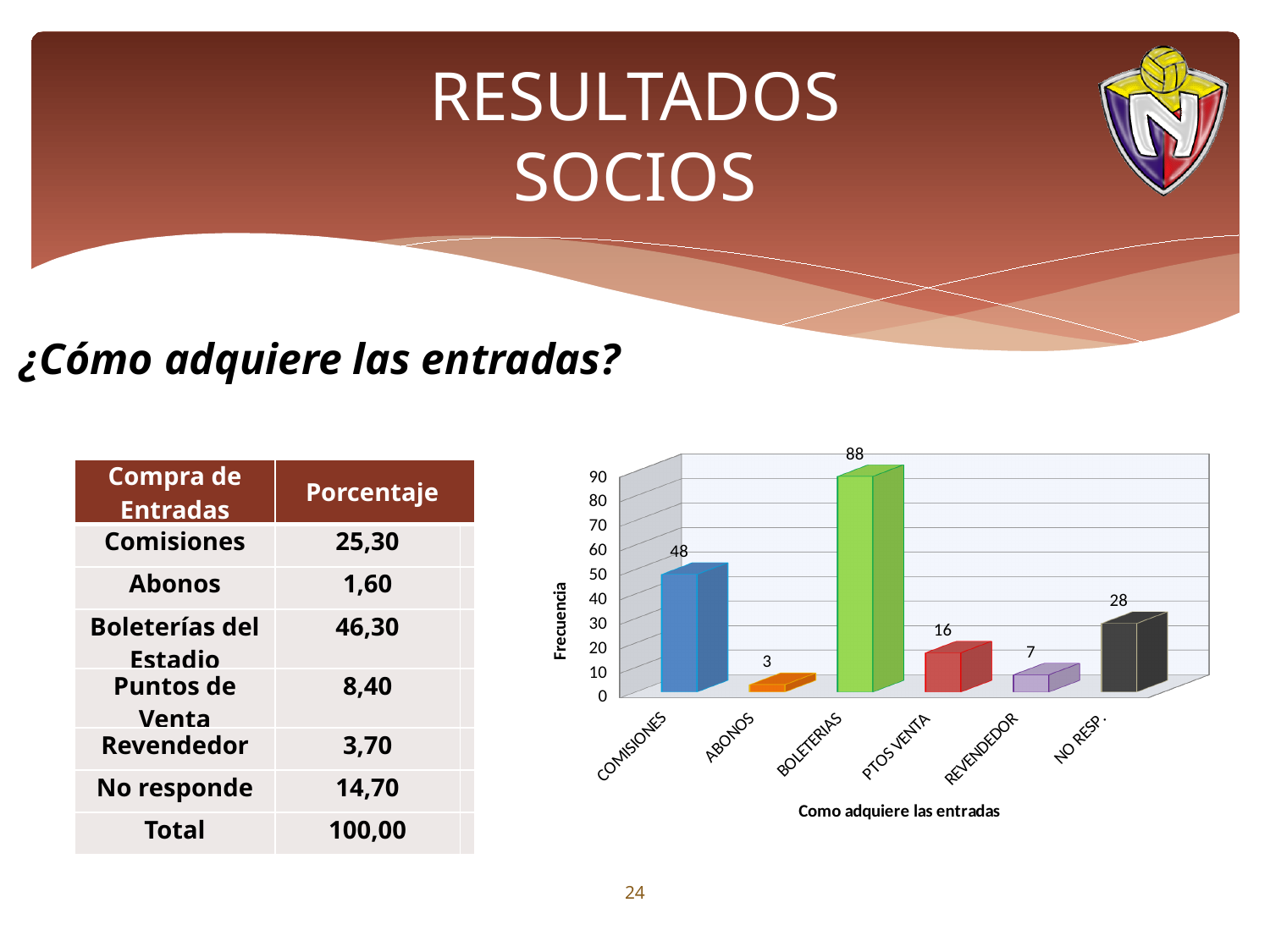
What is the frequency value for REVENDEDOR in the chart? 7 What is the label of the vertical axis of the chart? Frecuencia What kind of chart is shown on the slide? bar chart What is the frequency value for COMISIONES in the chart? 48 What is the difference between the frequency for BOLETERIAS and the frequency for COMISIONES? 40 Which category has the lowest frequency in the chart? ABONOS How many categories are shown on the x axis of the chart? 6 Which category has the highest frequency in the chart? BOLETERIAS What is the frequency value for NO RESP. in the chart? 28 Which has a higher frequency, PTOS VENTA or NO RESP.? NO RESP. What is the label of the horizontal axis of the chart? Como adquiere las entradas What is the frequency value for BOLETERIAS in the chart? 88